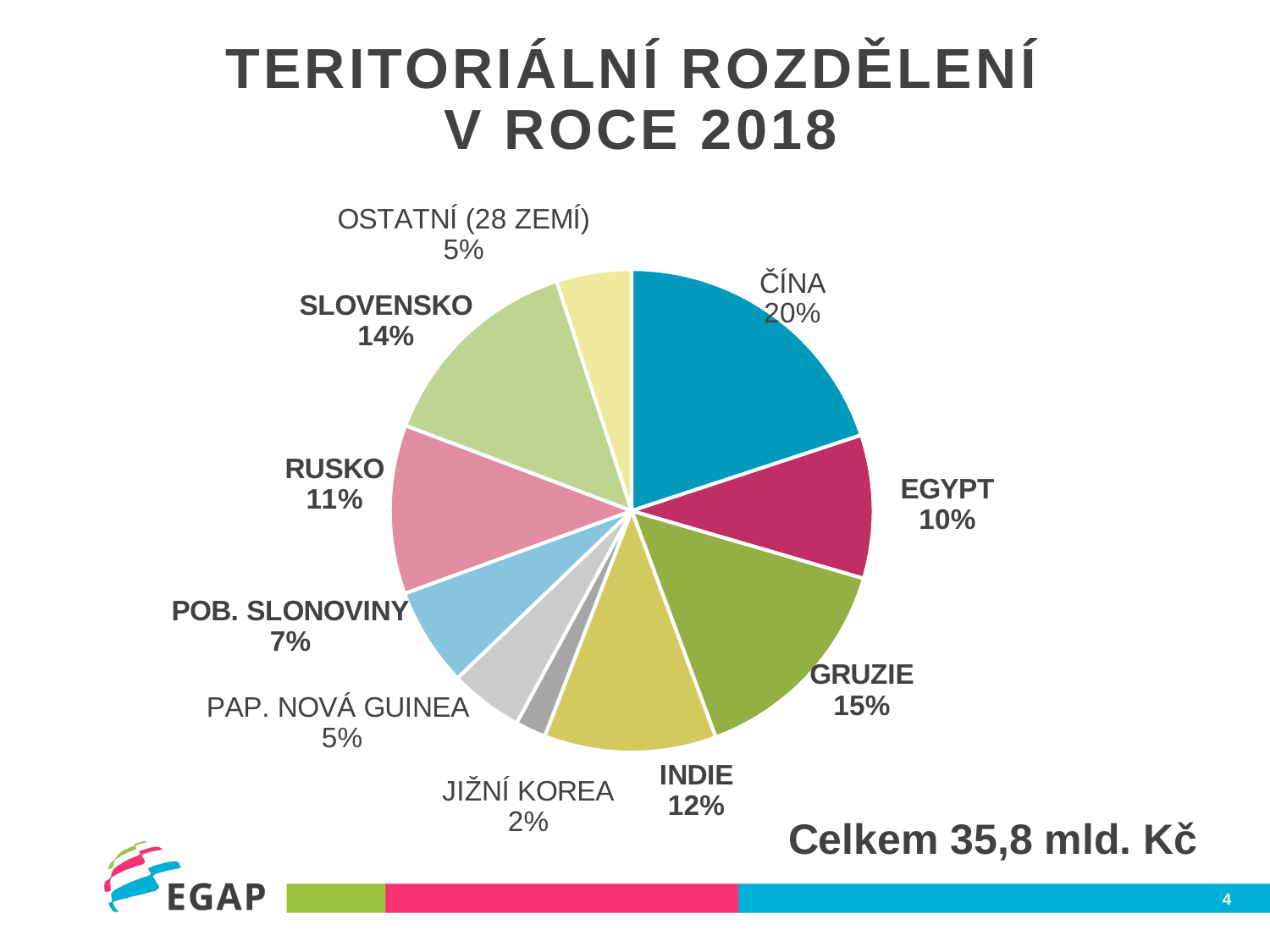
What kind of chart is shown on the slide? pie chart What is the value shown for POB. SLONOVINY? 7% What is the value shown for SLOVENSKO? 14% Which category has the largest slice of the pie? ČÍNA Which category has the smallest slice of the pie? JIŽNÍ KOREA What share of the pie does ČÍNA hold? 20% How many slices does the pie chart have? 10 What total amount is stated below the chart? 35,8 mld. Kč Which is larger, the share for RUSKO or the share for INDIE? INDIE What is the difference in percentage points between ČÍNA and EGYPT? 10 How many countries are grouped in the OSTATNÍ slice? 28 What share of the pie does GRUZIE hold? 15%